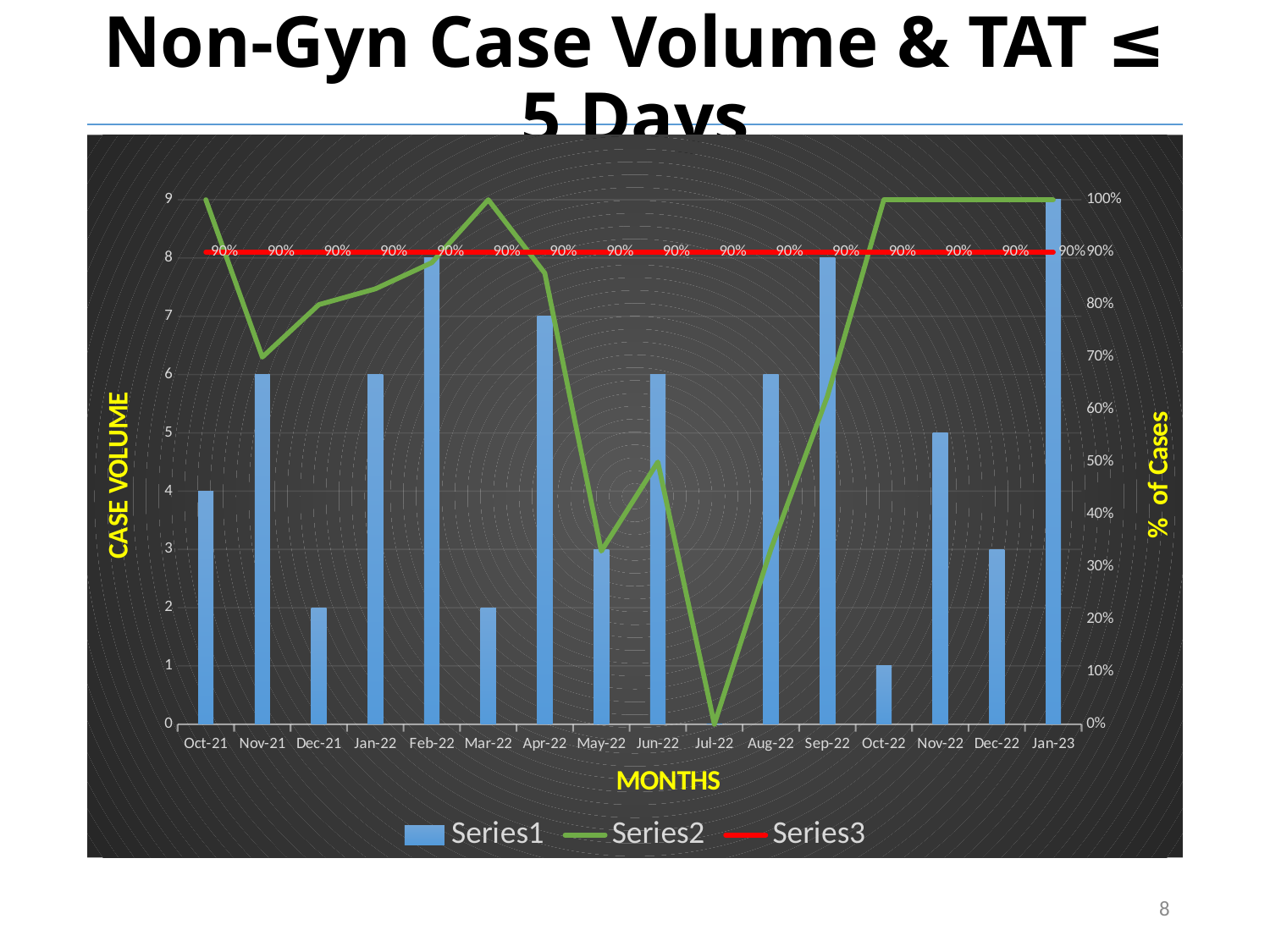
What value does the red Series3 line show for each month? 90% Which month has the lowest value on the green Series2 line? Jul-22 What is the case volume (Series1) for Feb-22? 8 What is the difference in case volume between Sep-22 and Oct-22? 7 Which month has the highest case volume (Series1)? Jan-23 How many months are shown on the x axis? 16 Which month has the larger case volume, Apr-22 or May-22? Apr-22 What is the label of the left vertical axis? CASE VOLUME How many series does the legend list? 3 What is the case volume (Series1) for Jan-23? 9 What kind of chart is this? Combination bar and line chart Is the green Series2 value for Nov-21 greater or less than 90%? less